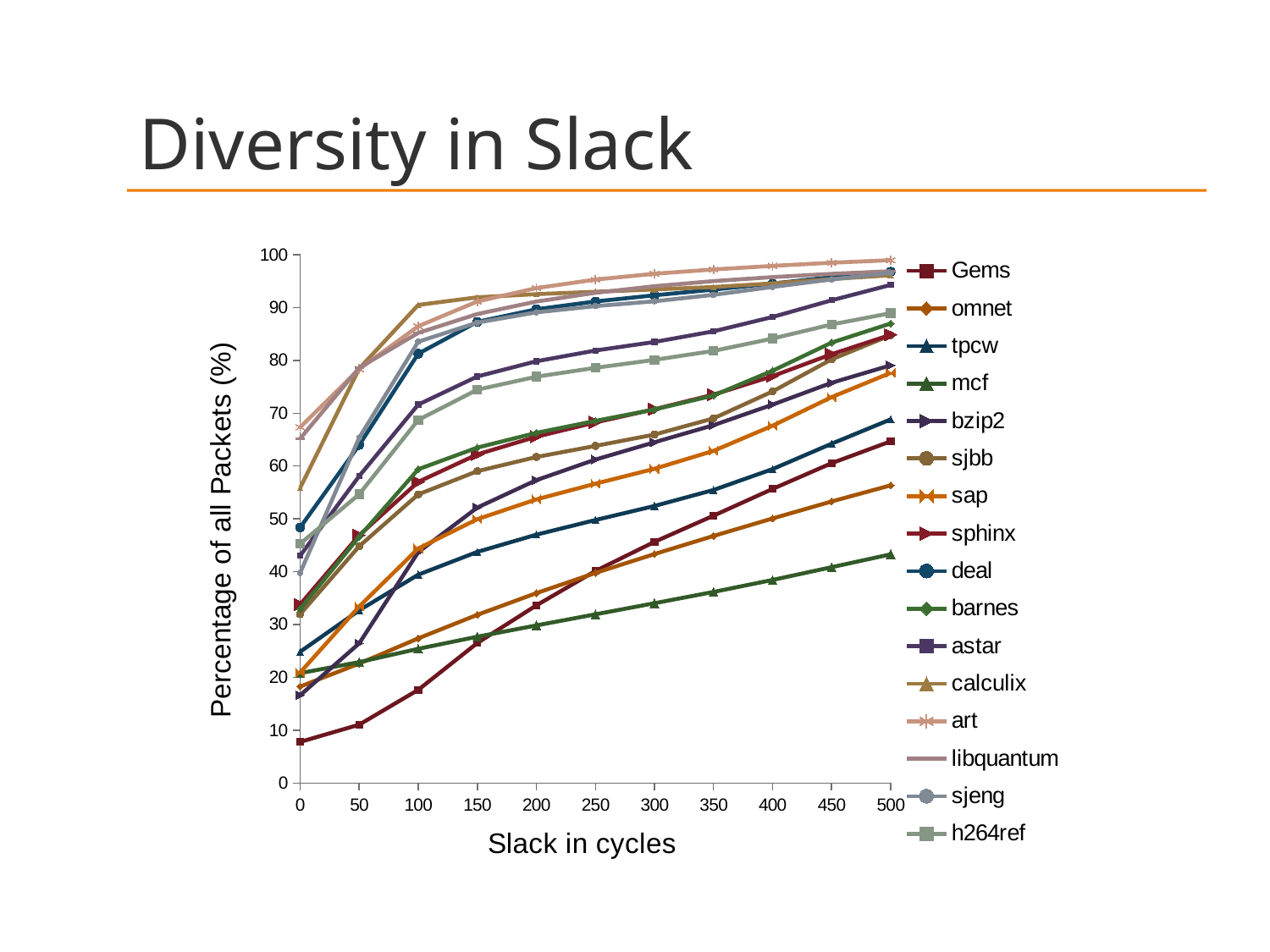
Is the value for art at a slack of 500 cycles greater or less than 90? greater What kind of chart is shown on the slide? line chart Do the values for the series rise or fall as slack increases along the x axis? rise At a slack of 500 cycles, which is larger, the value for Gems or the value for mcf? Gems Which series has the lowest value at a slack of 500 cycles? mcf How many slack values (x-axis points) are plotted for each series? 11 What is the label of the x axis? Slack in cycles Which series has the highest value at a slack of 500 cycles? art How many series does the legend list? 16 Which series has the lowest value at a slack of 0 cycles? Gems Is the value for mcf at a slack of 500 cycles greater or less than 50? less Is the value for Gems at a slack of 0 cycles greater or less than 10? less